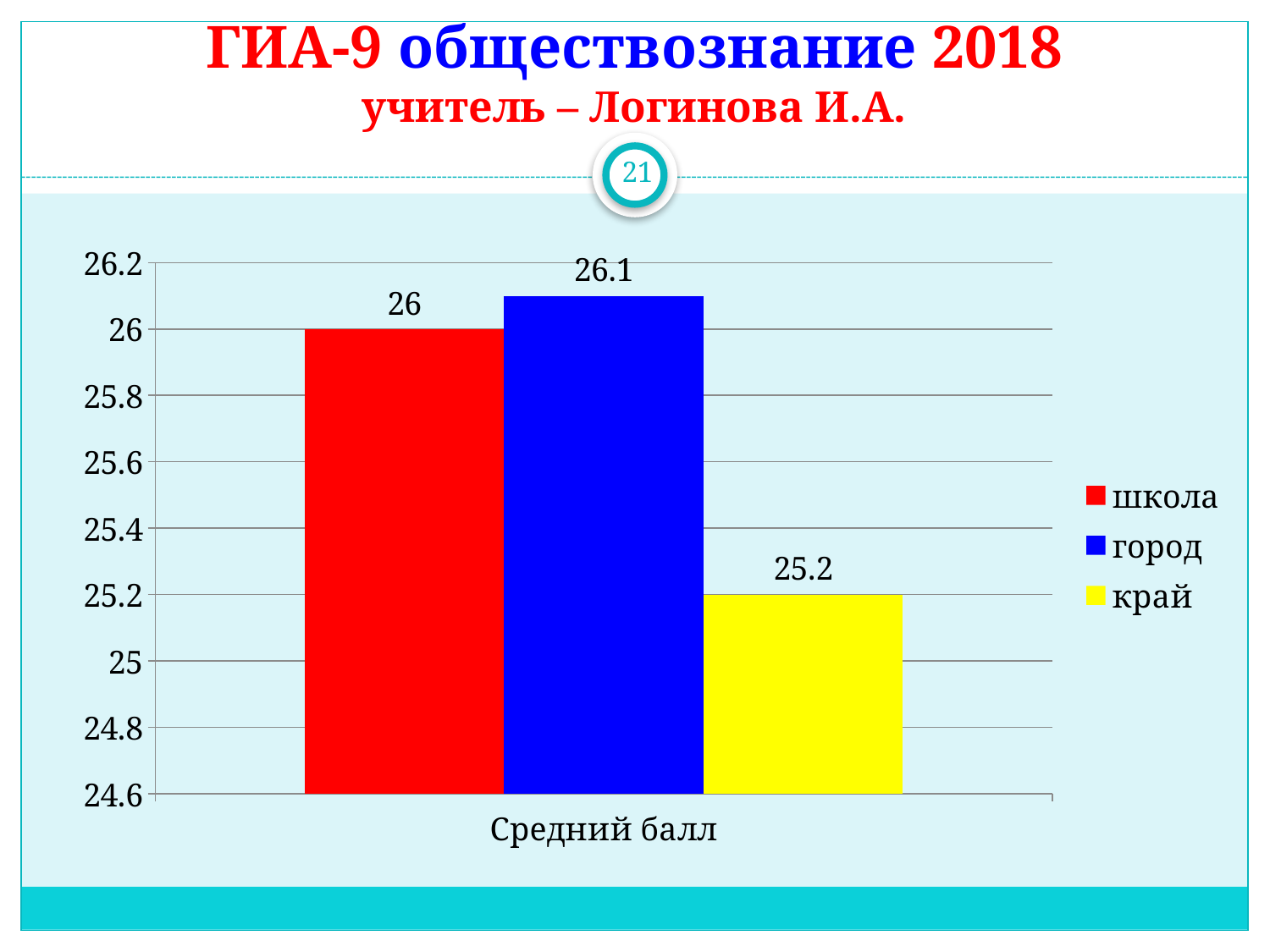
Which series has the highest value? город What is the value for школа in the chart? 26 How many series does the legend list? 3 What is the label on the x axis of the chart? Средний балл What kind of chart is shown on the slide? bar chart Which is larger, the value for школа or the value for край? школа What is the difference between the values for школа and край? 0.8 Is the value for край greater or less than 25.4? less Which series has the lowest value? край What is the value for город in the chart? 26.1 What is the difference between the values for город and край? 0.9 What is the value for край in the chart? 25.2